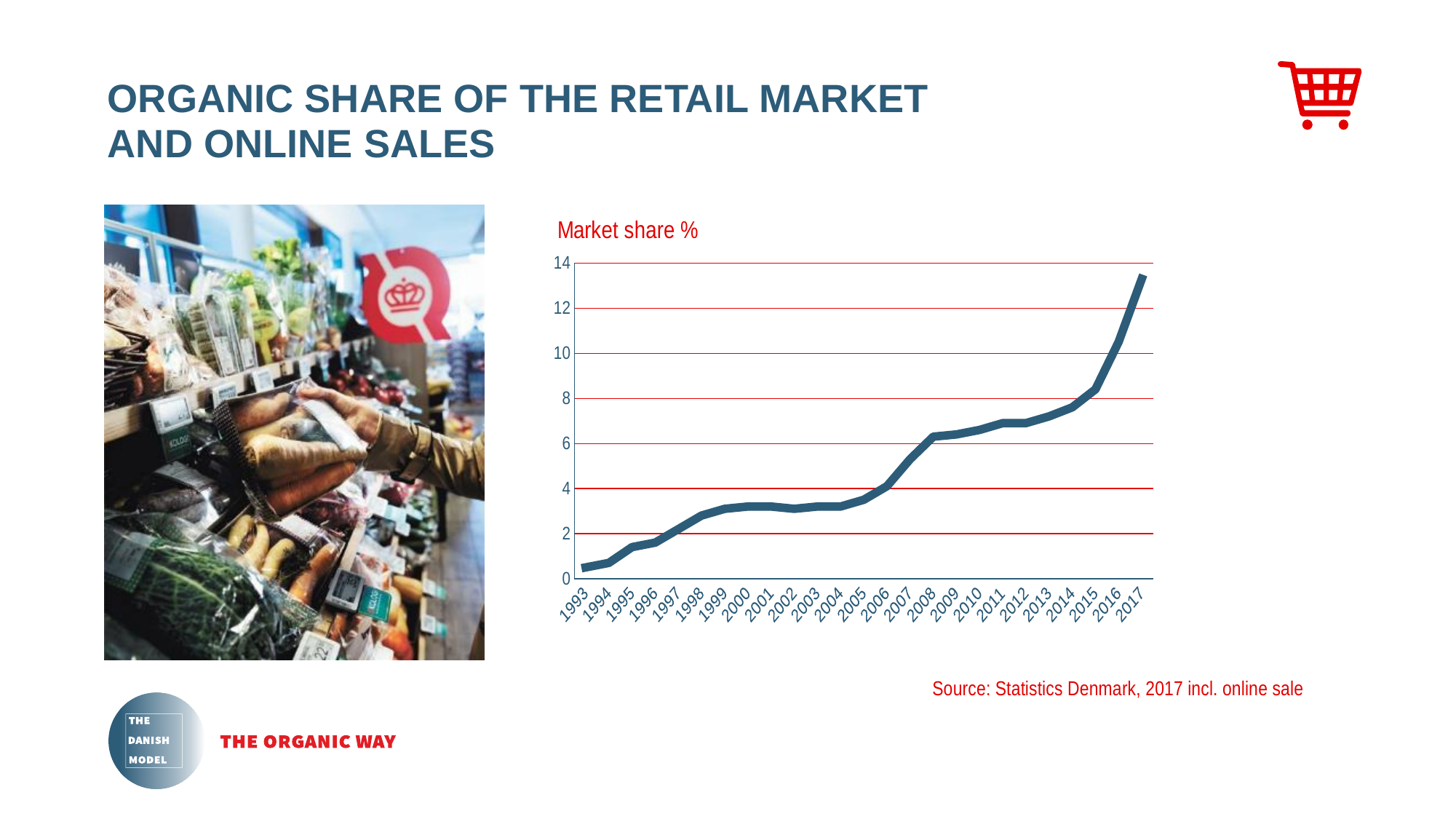
How many years are plotted along the x axis of the chart? 25 Which year has the lowest market share in the chart? 1993 Is the value for 1993 greater or less than 2? less Does the market share generally rise or fall from 1993 to 2017? rise Which year has the larger market share, 2015 or 2005? 2015 Which year has the highest market share in the chart? 2017 What is the title shown above the chart? Market share % Is the value for 2017 greater or less than 12? greater Is the value for 2000 greater or less than 4? less What is the first year shown on the x axis of the chart? 1993 What kind of chart is shown on the slide? line chart